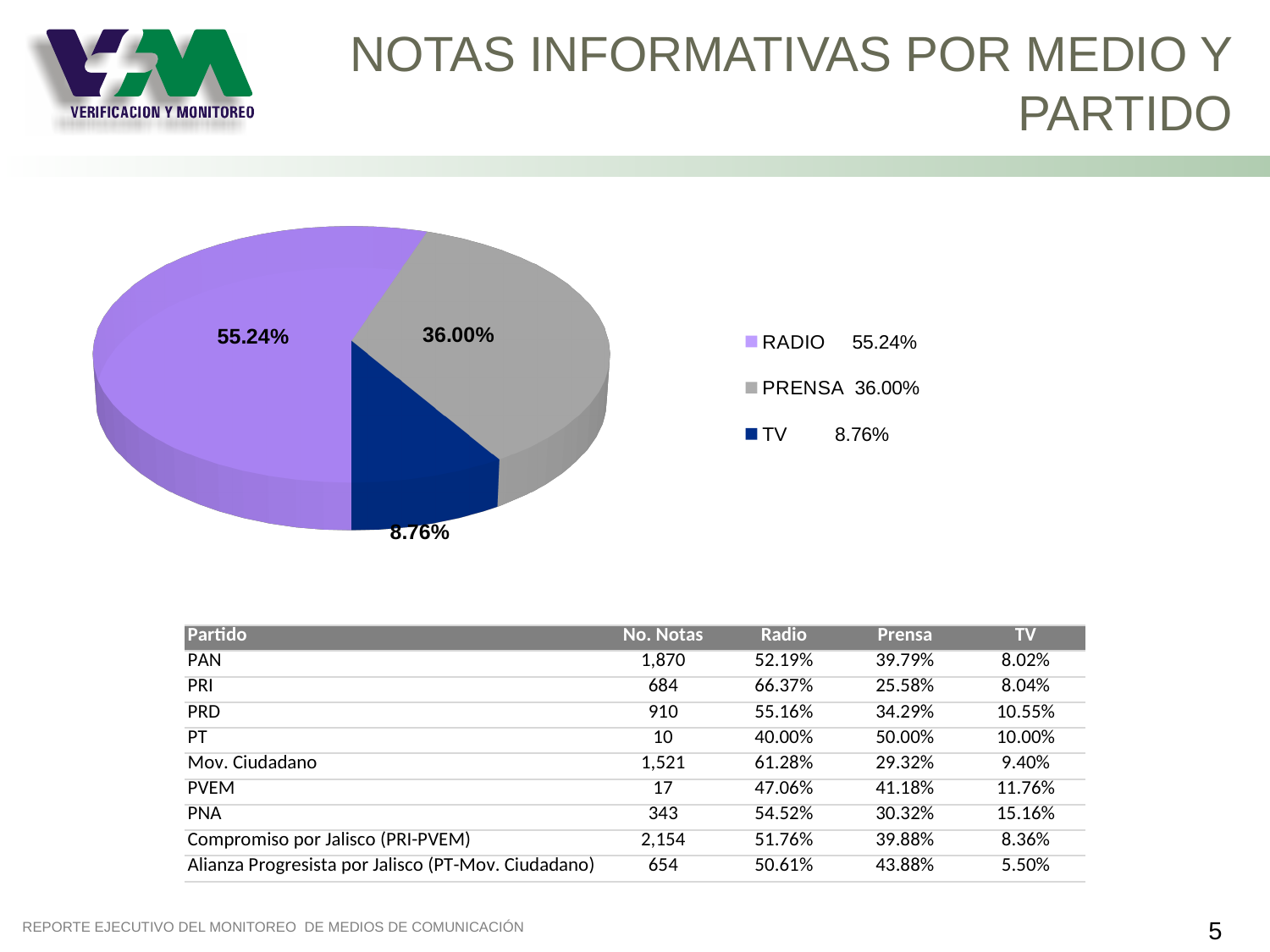
What is the difference in percentage points between the PRENSA and TV slices? 27.24 Which medium has the smallest slice in the pie chart? TV How many slices does the pie chart have? 3 What share of the pie chart does RADIO represent? 55.24% What share of the pie chart does PRENSA represent? 36.00% Which medium has the largest slice in the pie chart? RADIO What share of the pie chart does TV represent? 8.76% What type of chart is shown on the slide? Pie chart What colour is the TV slice in the pie chart? Dark blue What is the difference in percentage points between the RADIO and PRENSA slices? 19.24 How many entries does the pie chart legend list? 3 Which slice is larger, PRENSA or TV? PRENSA